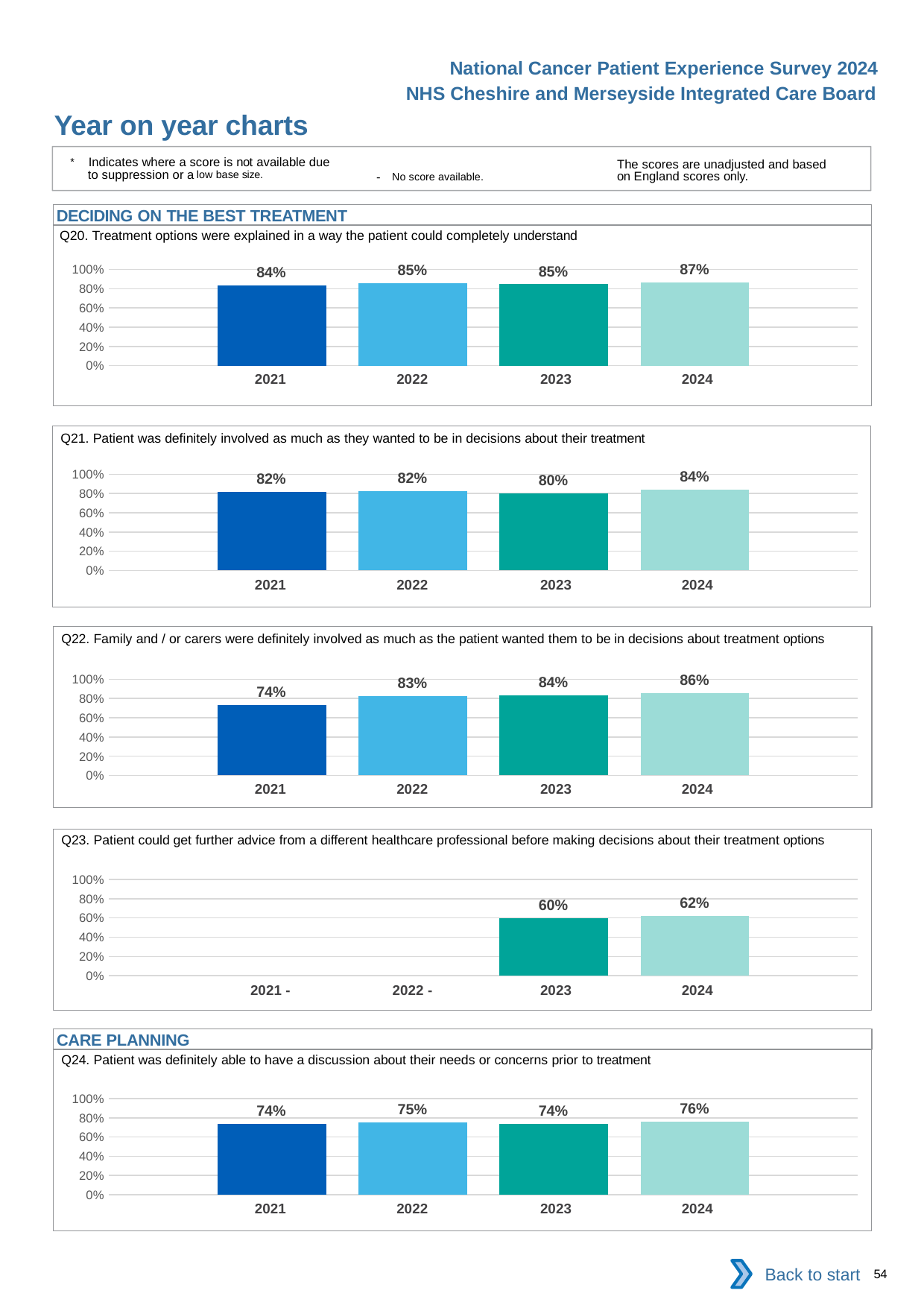
In the Q24 chart, what is the value for 2021? 74% In the Q22 chart, which year has the highest value? 2024 What type of chart is used for Q20? Bar chart In the Q21 chart, what is the difference between the 2024 value and the 2023 value? 4% In the Q23 chart, what is the value for 2023? 60% In the Q22 chart, what is the difference between the 2024 value and the 2021 value? 12% In the Q23 chart, how many years have a bar plotted? 2 In the Q21 chart, which year has the lowest value? 2023 In the Q22 chart, do the values rise or fall from 2021 to 2024? Rise In the Q24 chart, is the value for 2022 larger or smaller than the value for 2023? larger In the Q20 chart, what is the value for 2024? 87% In the Q23 chart, is the value for 2024 greater or less than 80%? less